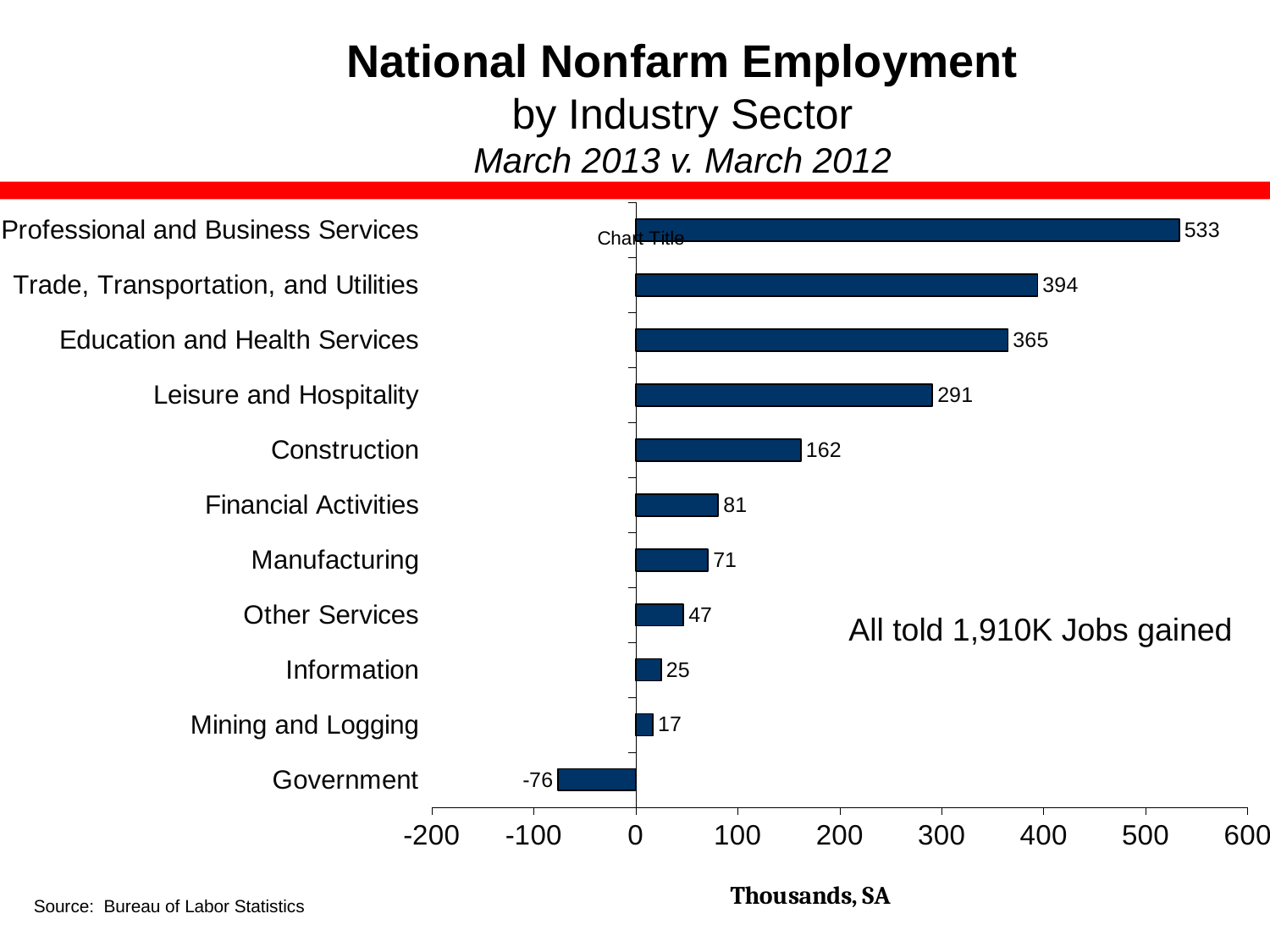
What is the difference between the values for Trade, Transportation, and Utilities and Education and Health Services? 29 What is the value for Government? -76 Which is larger, the value for Financial Activities or the value for Manufacturing? Financial Activities What is the value for Construction? 162 What is the value for Mining and Logging? 17 Which industry sector has the highest value? Professional and Business Services What unit is given for the x axis of the chart? Thousands, SA How many industry sectors are shown in the chart? 11 What is the value for Professional and Business Services? 533 Which industry sector has the lowest value? Government Is the value for Leisure and Hospitality greater or less than 300? less What kind of chart is shown on the slide? bar chart